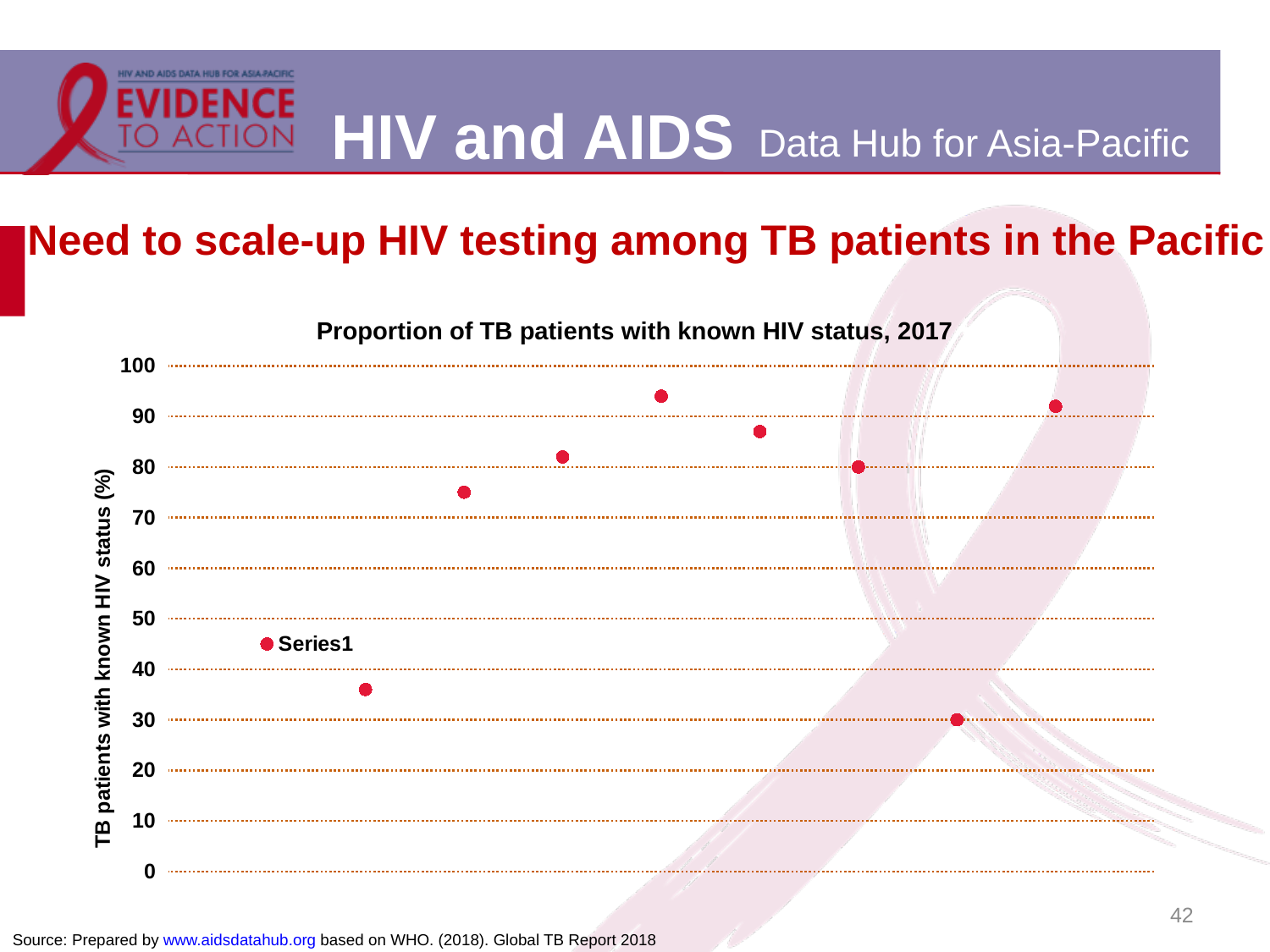
What is the label of the vertical axis? TB patients with known HIV status (%) What kind of chart is shown on the slide? Scatter chart What is the title of the chart? Proportion of TB patients with known HIV status, 2017 What is the highest value shown on the vertical axis? 100 Is the value of the leftmost point in the chart greater or less than 50? less Is the value of the rightmost point in the chart greater or less than 80? greater How many data points are plotted in the chart? 9 Is the value of the lowest point in the chart greater or less than 40? less How many points in the chart have values below 50? 3